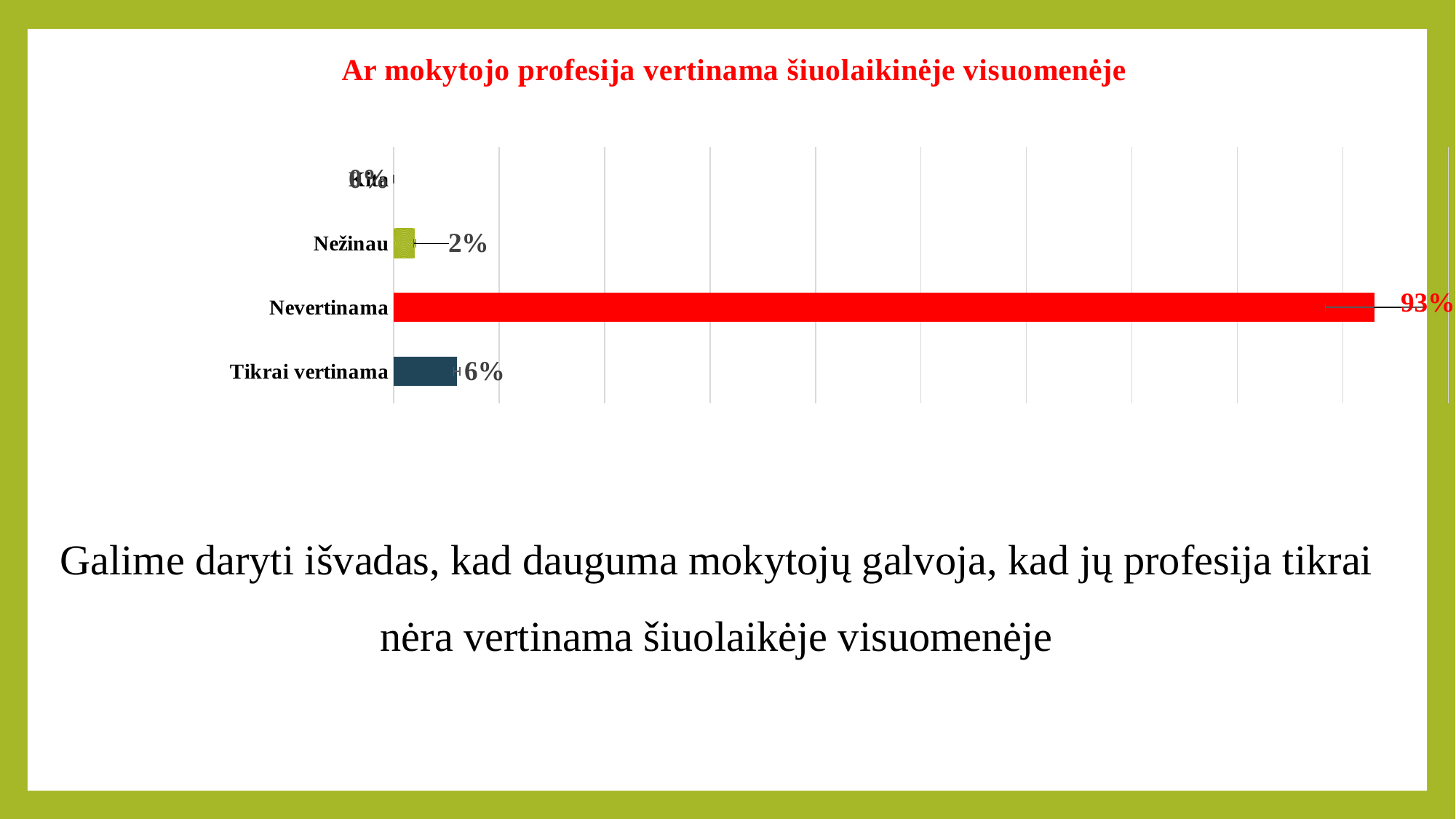
What is the value for Nežinau? 2% Which is larger, Tikrai vertinama or Nežinau? Tikrai vertinama What is the value for Tikrai vertinama? 6% What colour is the bar for Nevertinama? red What is the difference between the values for Tikrai vertinama and Nežinau? 4% Which category has the highest value? Nevertinama How many categories are shown in the chart? 4 What is the value for Nevertinama? 93% What is the difference between the values for Nevertinama and Tikrai vertinama? 87% What kind of chart is shown on the slide? bar chart What is the title of the chart? Ar mokytojo profesija vertinama šiuolaikinėje visuomenėje